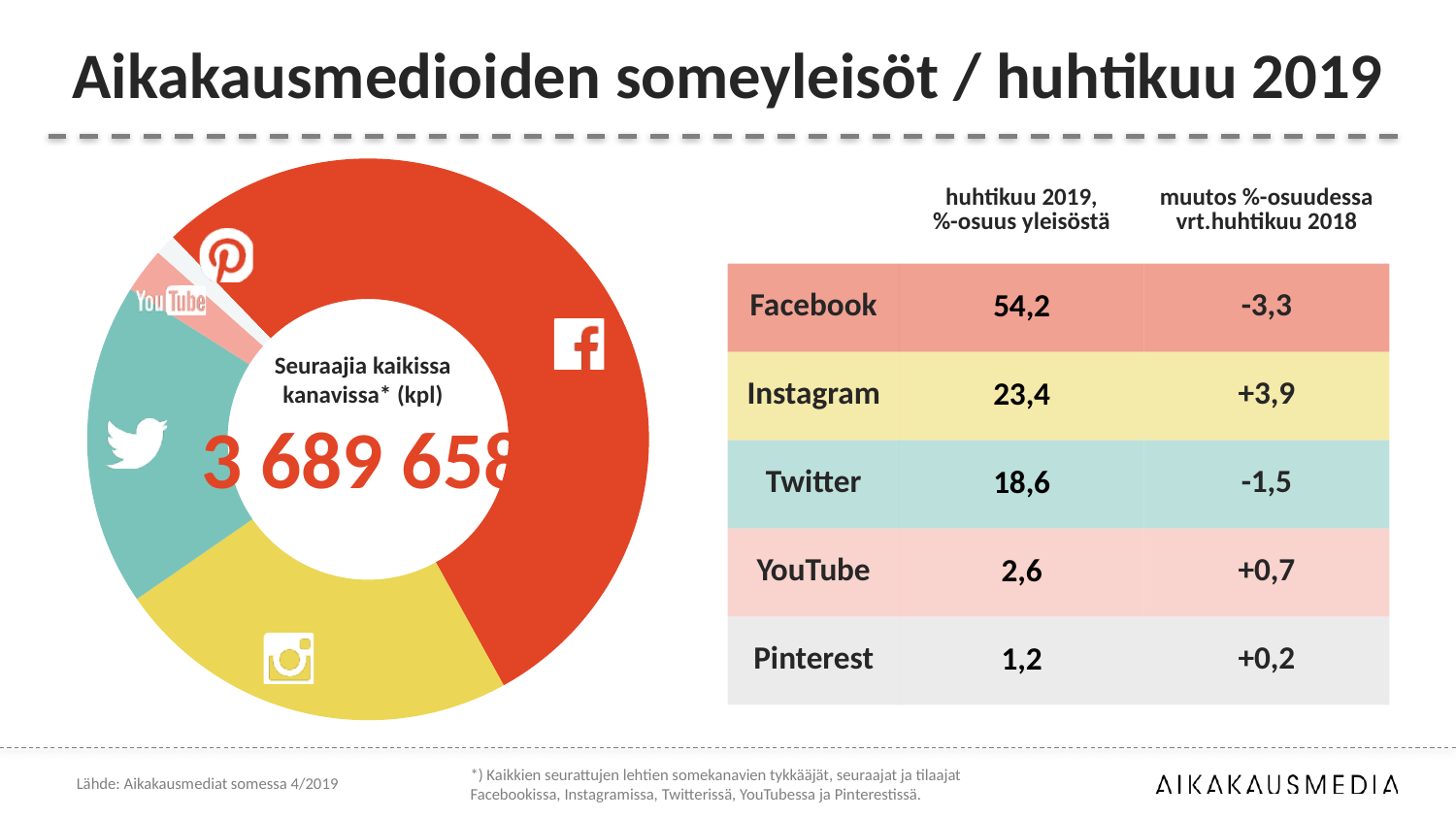
Which channel has the smallest share of the audience in April 2019? Pinterest Which has a larger share of the audience, Twitter or YouTube? Twitter What total number of followers across all channels is printed in the centre of the donut chart? 3 689 658 How many slices does the donut chart have? 5 What is the difference between Facebook's and Instagram's shares of the audience in April 2019? 30,8 According to the table, what is Facebook's share of the audience in April 2019? 54,2 According to the table, what is Twitter's share of the audience in April 2019? 18,6 What kind of chart is shown on the left of the slide? Pie chart (donut) According to the table, what is Instagram's share of the audience in April 2019? 23,4 What is the change in percentage share for Instagram compared with April 2018? +3,9 What is the change in percentage share for Facebook compared with April 2018? -3,3 Which channel has the largest slice of the donut chart? Facebook